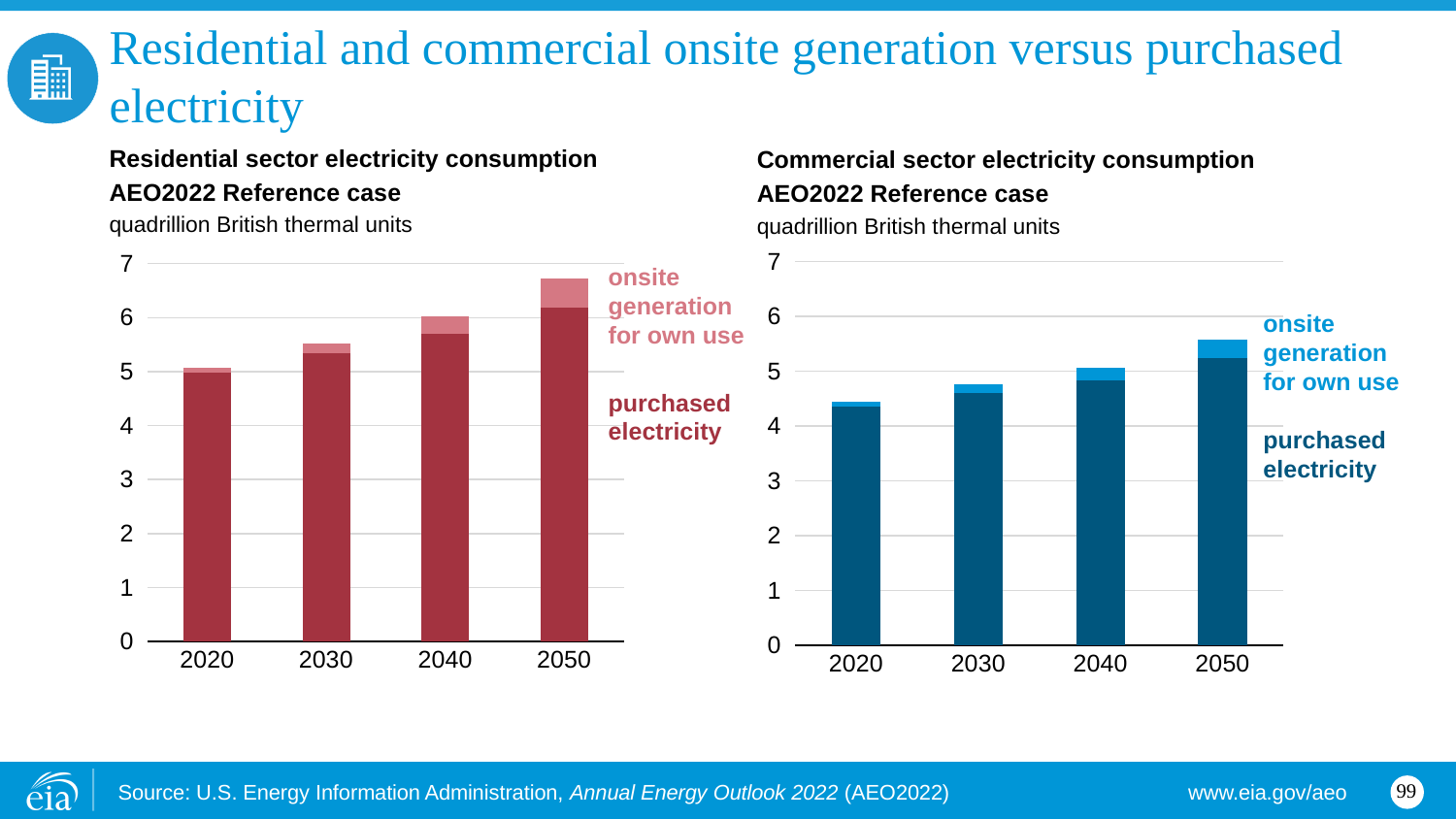
What kind of chart is the Residential sector electricity consumption chart? stacked bar chart In the Residential sector electricity consumption chart, which year has the tallest bar? 2050 In the Commercial sector electricity consumption chart, which series makes up the larger part of each bar? purchased electricity In the Commercial sector electricity consumption chart, is the total bar for 2050 greater or less than 5? greater In the Commercial sector electricity consumption chart, which year has the shortest bar? 2020 Which is larger: the total bar for 2050 in the Residential chart or the total bar for 2050 in the Commercial chart? Residential In the Commercial sector electricity consumption chart, is the total bar for 2020 greater or less than 5? less In the Residential sector electricity consumption chart, do total bar heights rise or fall from 2020 to 2050? rise How many series are shown in the Residential sector electricity consumption chart? 2 How many years are shown on the x axis of the Commercial sector electricity consumption chart? 4 What unit is used on the y axis of both charts? quadrillion British thermal units In the Residential sector electricity consumption chart, is the total bar for 2050 greater or less than 6? greater